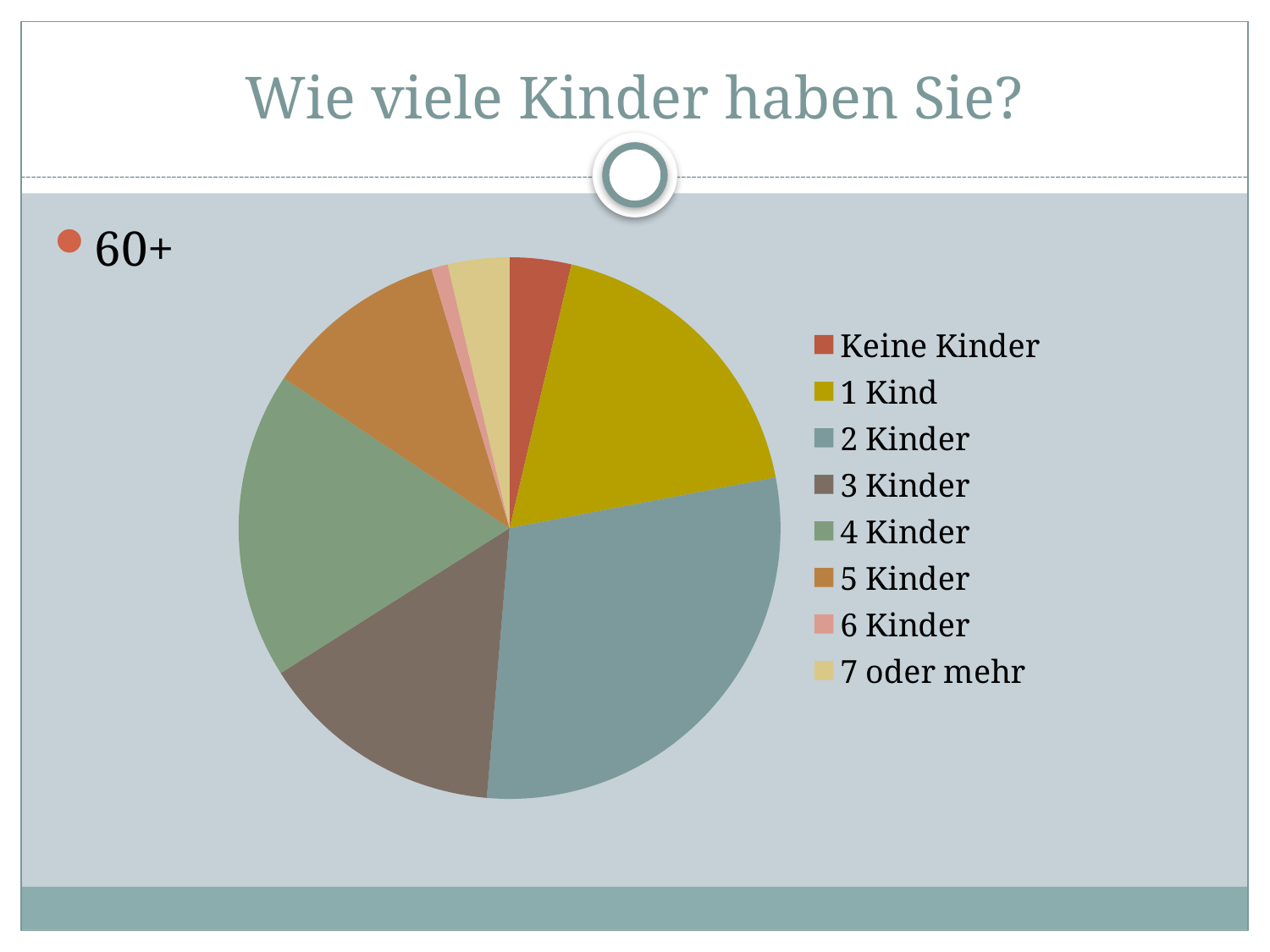
What is the title of the slide containing the pie chart? Wie viele Kinder haben Sie? Which slice is larger, 6 Kinder or 7 oder mehr? 7 oder mehr Which slice is larger, 3 Kinder or 5 Kinder? 3 Kinder Which category has the largest slice of the pie chart? 2 Kinder What kind of chart is shown on the slide? pie chart Which slice is larger, Keine Kinder or 4 Kinder? 4 Kinder How many categories does the pie chart have? 8 Which legend entry is shown in red? Keine Kinder Which category has the smallest slice of the pie chart? 6 Kinder